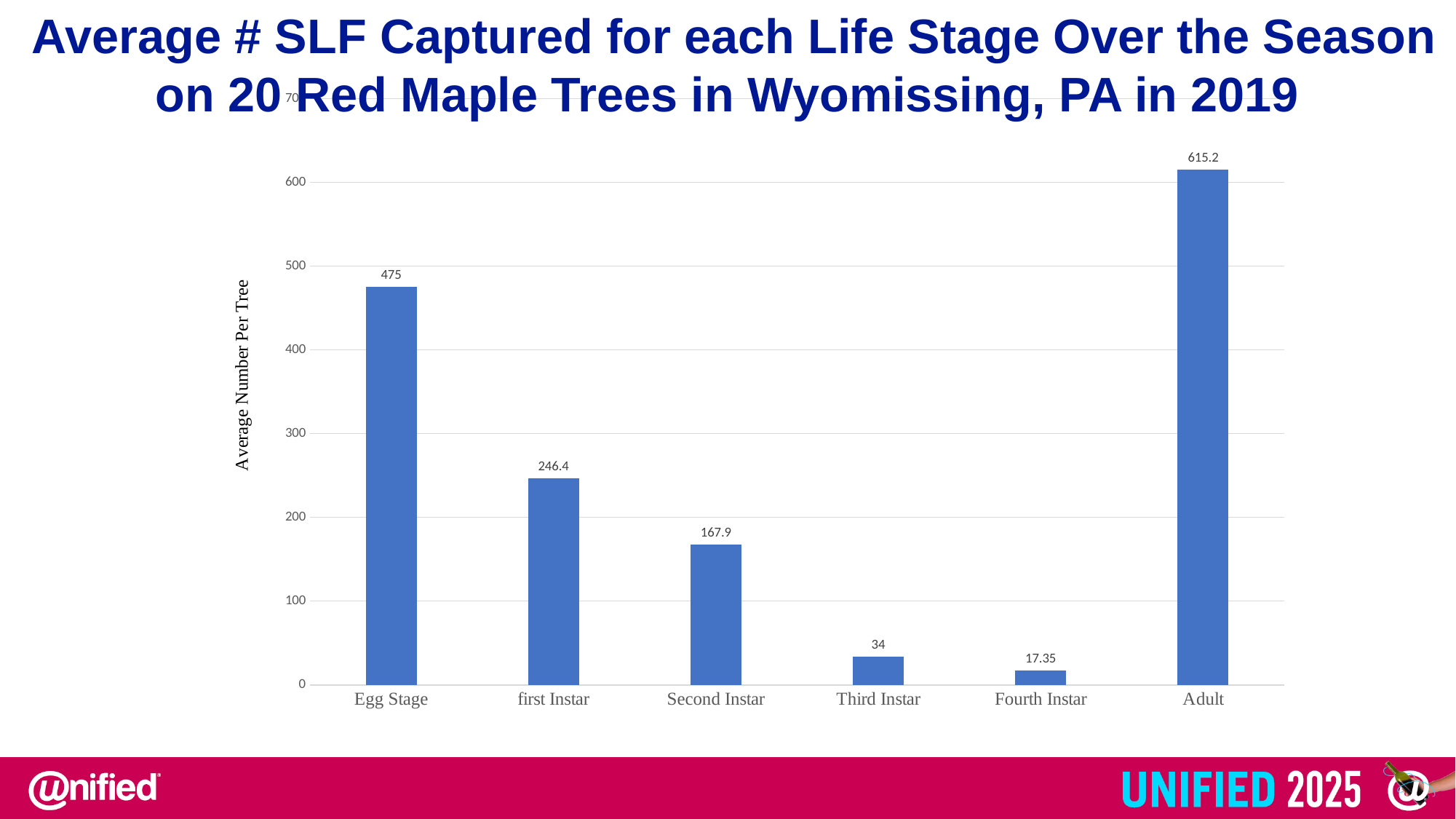
What is the label of the vertical axis? Average Number Per Tree Is the value for first Instar greater or less than 200? greater What is the average number per tree for the Adult stage? 615.2 Which is larger, the value for Third Instar or the value for Fourth Instar? Third Instar What is the difference between the Egg Stage value and the first Instar value? 228.6 Which life stage has the highest average number per tree? Adult What is the value shown for Second Instar? 167.9 What kind of chart is shown on the slide? Bar chart Which life stage has the lowest average number per tree? Fourth Instar What is the average number per tree for the Egg Stage? 475 How many life stages are shown on the x axis? 6 What is the value shown for Fourth Instar? 17.35